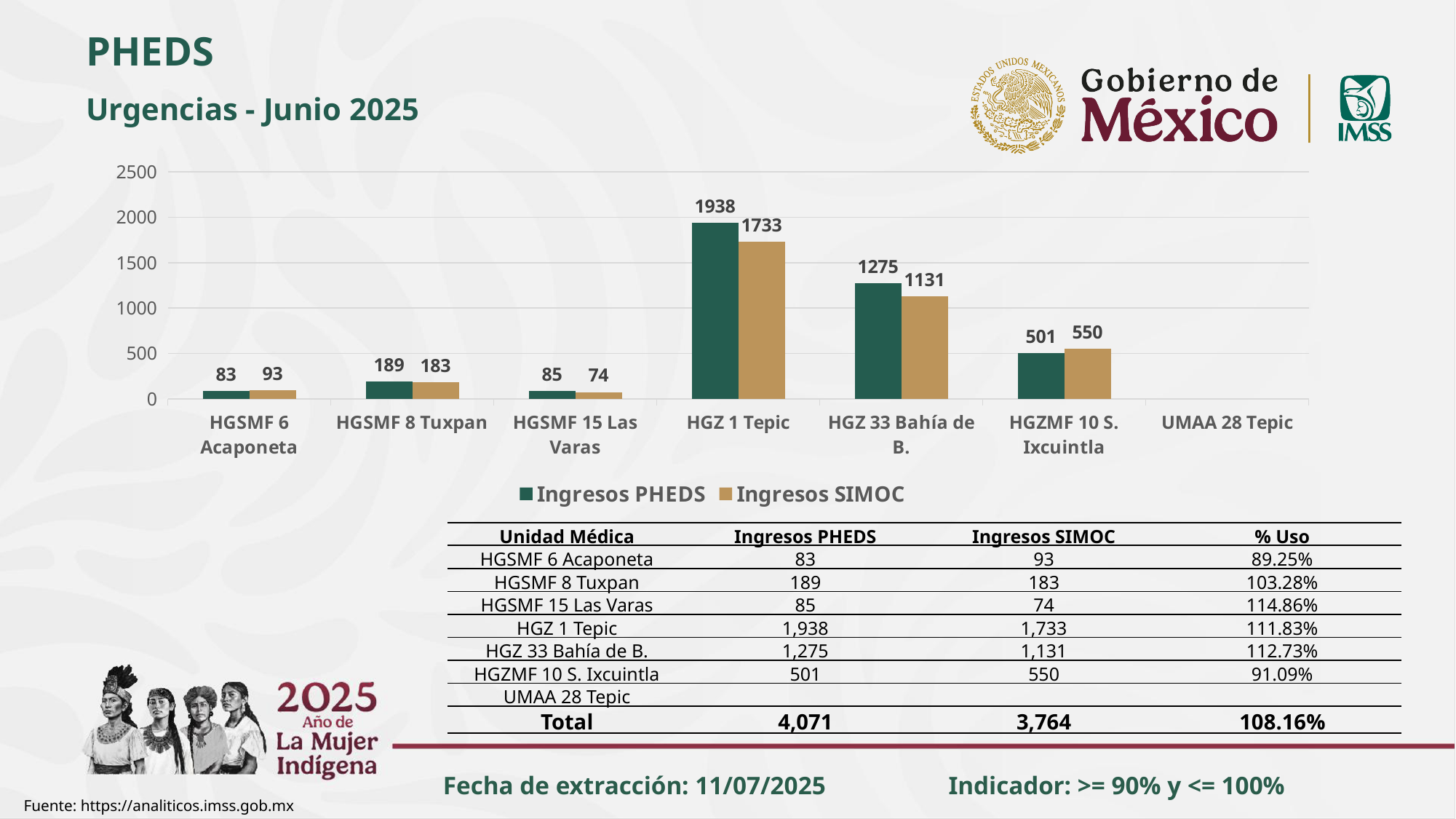
What is the Ingresos SIMOC value for HGSMF 15 Las Varas? 74 For HGSMF 6 Acaponeta, which is larger: Ingresos PHEDS or Ingresos SIMOC? Ingresos SIMOC How many series does the legend list? 2 Which category with a plotted bar has the lowest Ingresos SIMOC value? HGSMF 15 Las Varas What is the difference between Ingresos PHEDS and Ingresos SIMOC for HGZ 33 Bahía de B.? 144 What kind of chart is shown on the slide? Bar chart What is the Ingresos SIMOC value for HGZMF 10 S. Ixcuintla? 550 Which category has the highest Ingresos PHEDS value? HGZ 1 Tepic Is the Ingresos PHEDS value for HGZ 33 Bahía de B. greater or less than 1000? greater How many categories are shown on the x axis of the chart? 7 What is the Ingresos PHEDS value for HGZ 1 Tepic? 1938 Which series is shown in dark green in the chart? Ingresos PHEDS